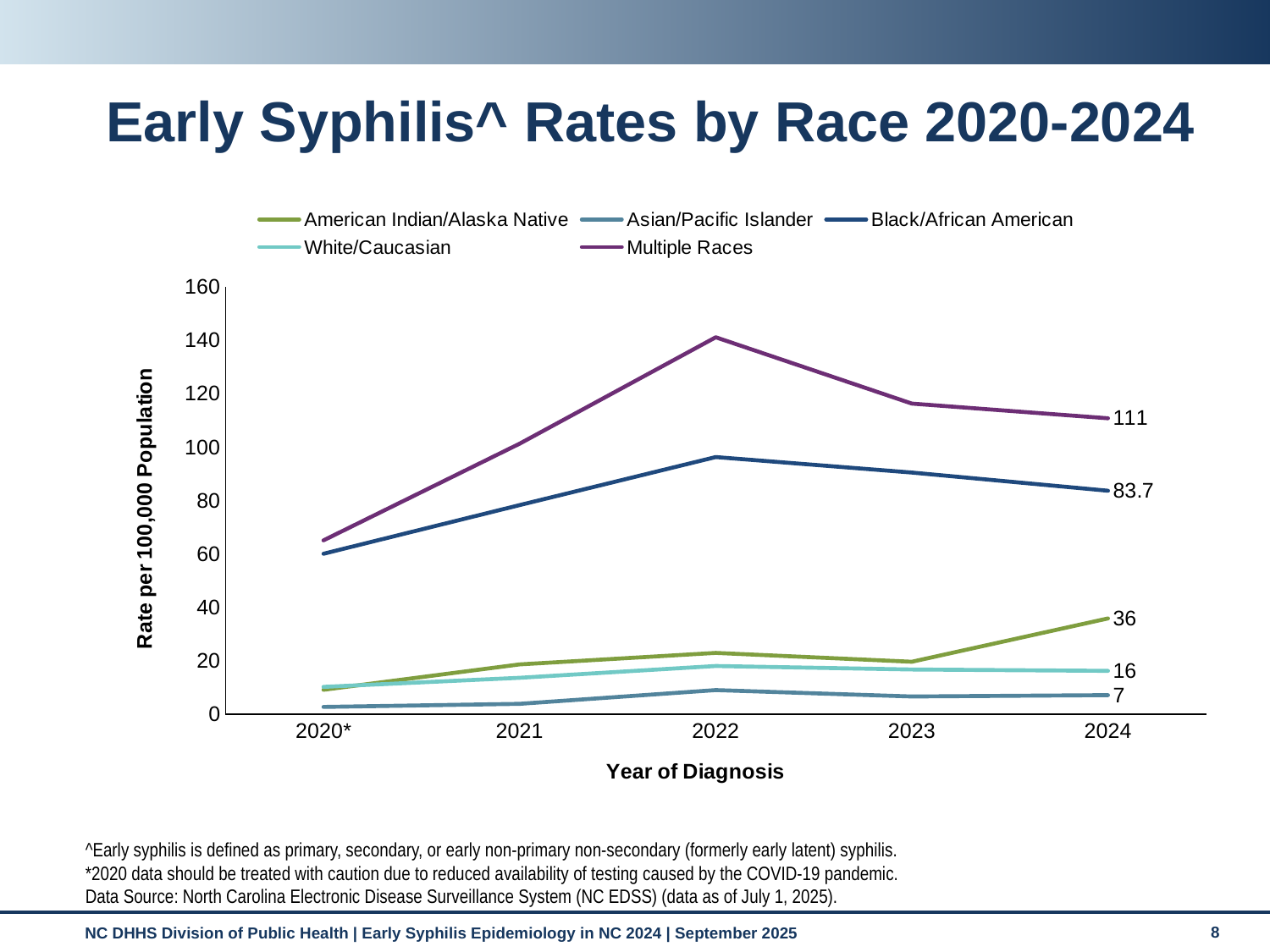
What kind of chart is shown on the slide? Line chart What is the 2024 early syphilis rate for American Indian/Alaska Native? 36 What is the label of the y axis? Rate per 100,000 Population What is the difference between the 2024 rates for Multiple Races and Black/African American? 27.3 What is the 2024 early syphilis rate for Multiple Races? 111 What is the 2024 early syphilis rate for Black/African American? 83.7 What is the 2024 early syphilis rate for Asian/Pacific Islander? 7 Which race group has the lowest early syphilis rate in 2024? Asian/Pacific Islander How many series does the legend list? 5 Which race group has the highest early syphilis rate in 2024? Multiple Races In 2024, which is larger: the rate for American Indian/Alaska Native or the rate for White/Caucasian? American Indian/Alaska Native Is the 2022 rate for Multiple Races greater or less than 120? greater